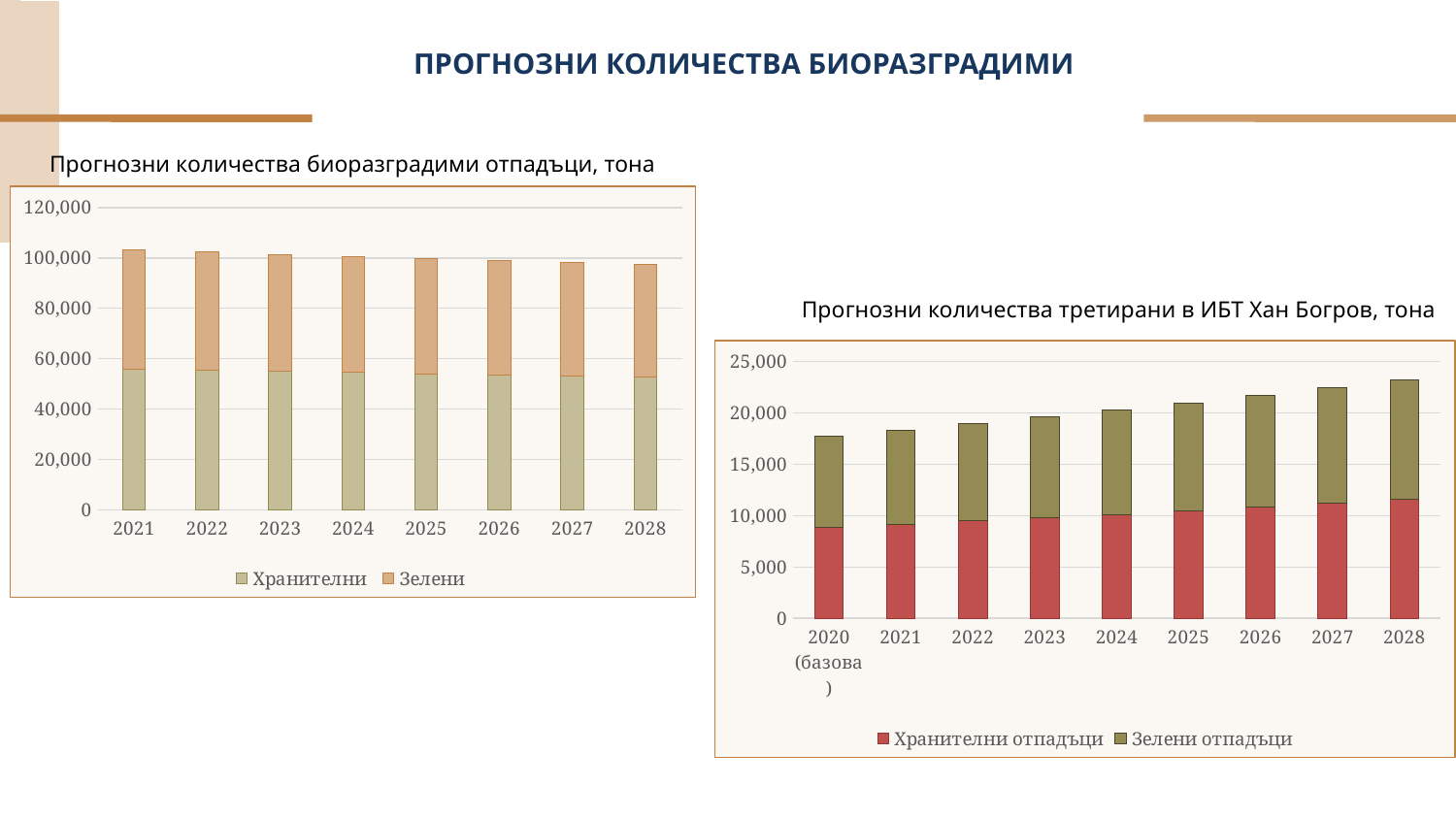
In the left chart "Прогнозни количества биоразградими отпадъци, тона", how many years are shown on the x axis? 8 In the right chart "Прогнозни количества третирани в ИБТ Хан Богров, тона", do the total bar heights rise or fall from 2020 to 2028? rise In the right chart "Прогнозни количества третирани в ИБТ Хан Богров, тона", which year has the lowest total? 2020 (базова) In the left chart "Прогнозни количества биоразградими отпадъци, тона", how many series does the legend list? 2 In the left chart "Прогнозни количества биоразградими отпадъци, тона", is the total for 2028 greater or less than 100,000? less In the left chart "Прогнозни количества биоразградими отпадъци, тона", do the total bar heights rise or fall from 2021 to 2028? fall In the left chart "Прогнозни количества биоразградими отпадъци, тона", which year has the highest total? 2021 In the right chart "Прогнозни количества третирани в ИБТ Хан Богров, тона", what are the two series listed in the legend? Хранителни отпадъци and Зелени отпадъци What kind of chart is the left chart titled "Прогнозни количества биоразградими отпадъци, тона"? stacked bar chart In the left chart "Прогнозни количества биоразградими отпадъци, тона", is the Хранителни value for 2021 greater or less than 60,000? less In the right chart "Прогнозни количества третирани в ИБТ Хан Богров, тона", how many years are shown on the x axis? 9 In the right chart "Прогнозни количества третирани в ИБТ Хан Богров, тона", is the total for 2028 greater or less than 20,000? greater